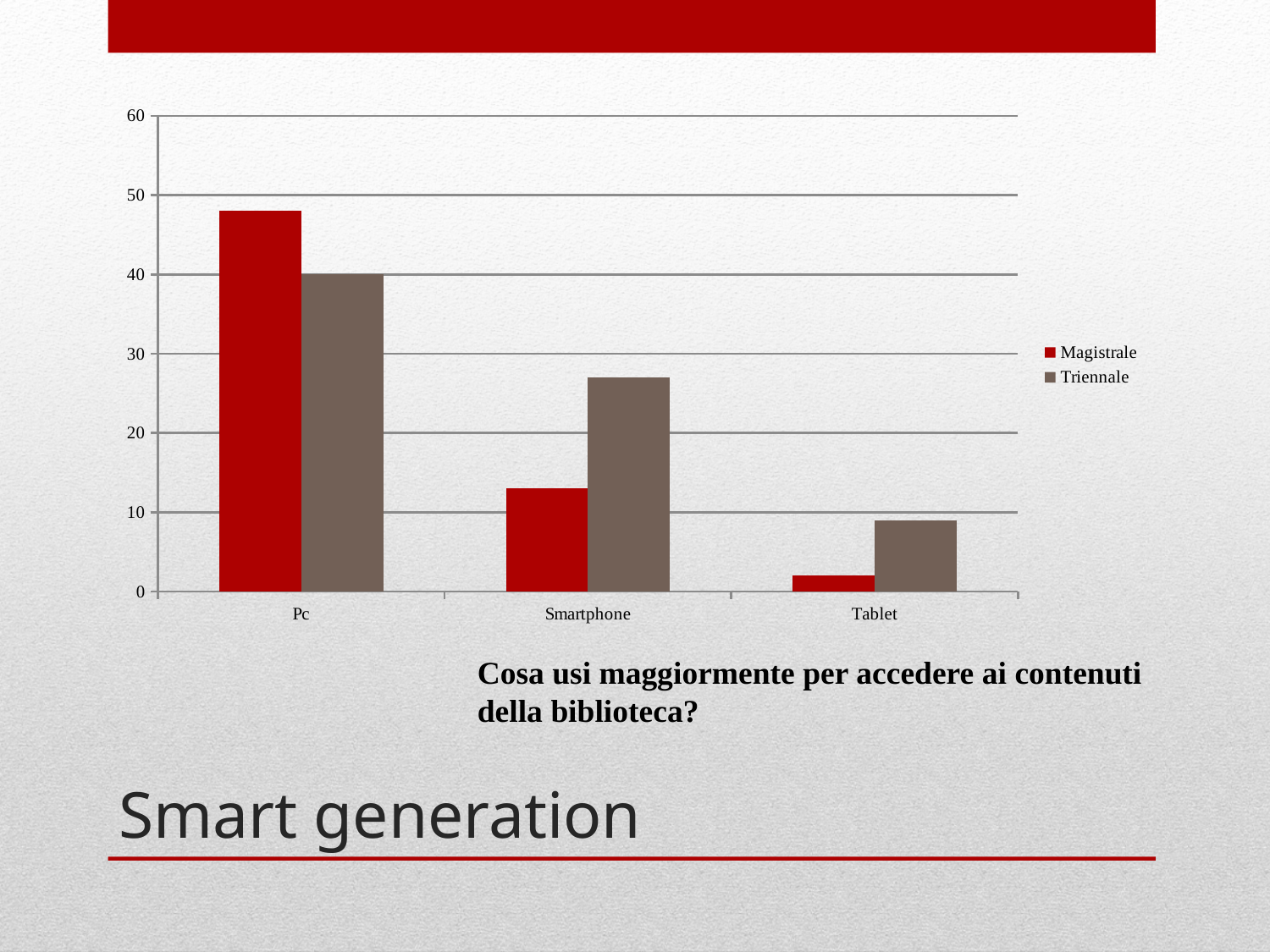
Is the Triennale value for Tablet greater or less than 10? less What colour are the Magistrale bars? red Do the Triennale values rise or fall from Pc to Tablet along the x axis? fall How many series does the legend list? 2 What kind of chart is shown on the slide? bar chart For Smartphone, which series has the larger value, Magistrale or Triennale? Triennale Is the Magistrale value for Pc greater or less than 40? greater Which category has the highest value for the Magistrale series? Pc For Pc, which series has the larger value, Magistrale or Triennale? Magistrale Is the Triennale value for Smartphone greater or less than 30? less How many categories are shown on the x axis? 3 Which category has the lowest value for the Triennale series? Tablet